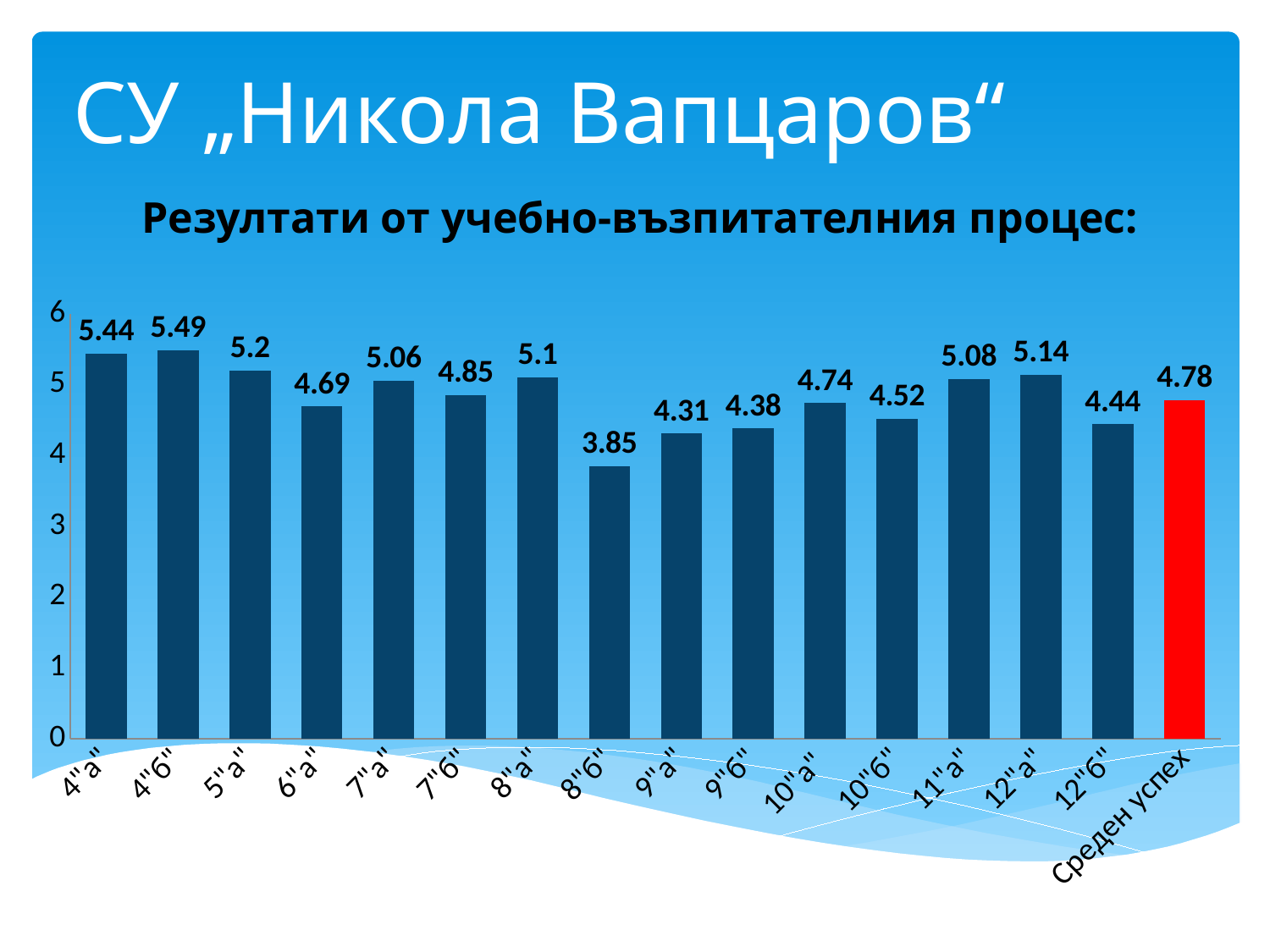
Is the value for 8"б" greater or less than 4? less What kind of chart is shown on the slide? bar chart What is the value for 10"а"? 4.74 What is the value for Среден успех? 4.78 What is the difference between the values for 4"б" and 8"б"? 1.64 Which category's bar is coloured red? Среден успех What is the value for 8"б"? 3.85 Which is larger, the value for 5"а" or the value for 12"а"? 5"а" Which category has the lowest value? 8"б" Which category has the highest value? 4"б" What is the value for 4"а"? 5.44 How many categories are shown on the x axis? 16